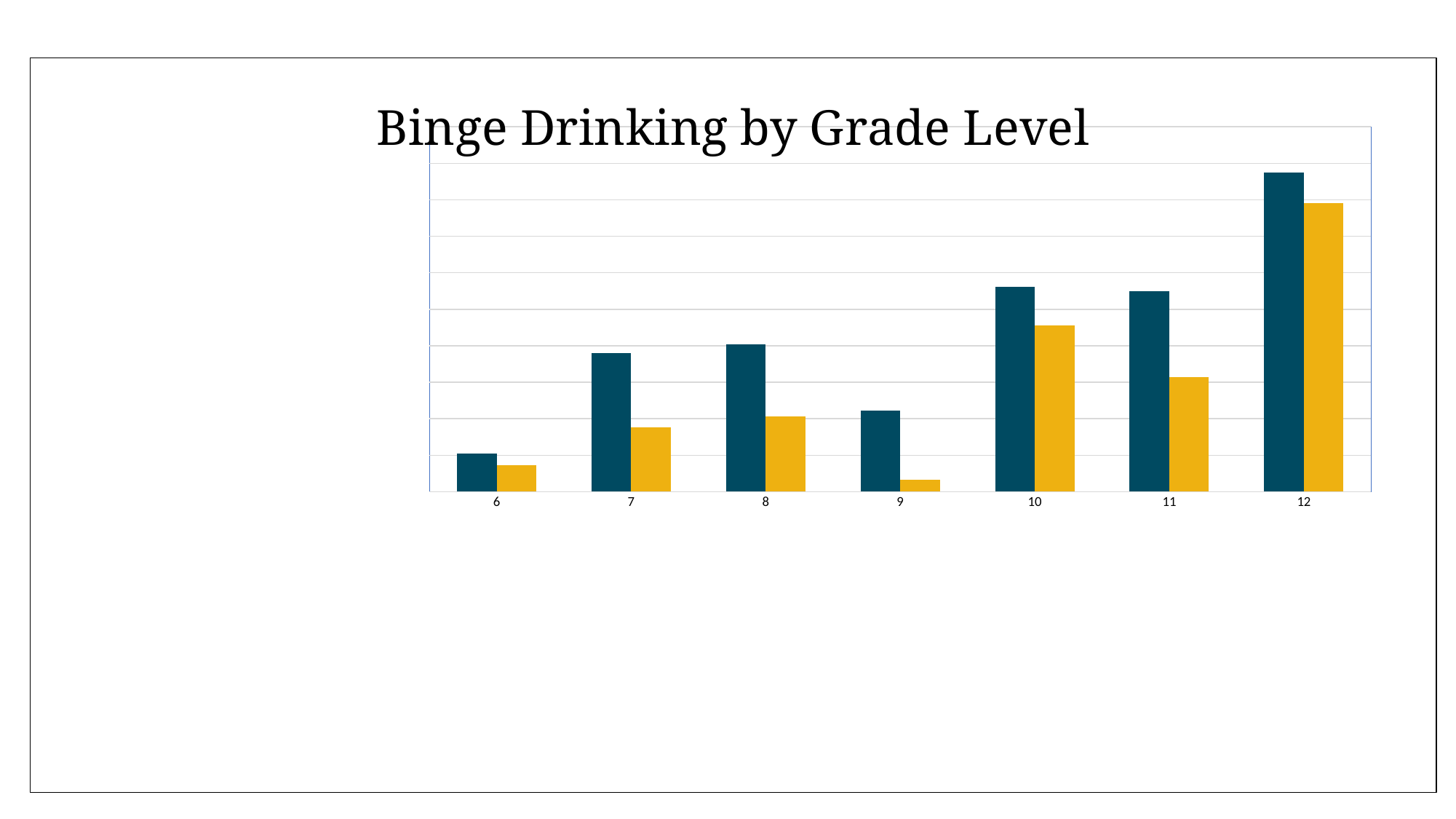
From grade 9 to grade 12, do the dark blue bars rise or fall? rise How many grade levels are shown on the x axis of the chart? 7 Which grade level has the shortest dark blue bar? 6 What is the title of the chart? Binge Drinking by Grade Level Which grade level has the tallest dark blue bar? 12 At grade 9, which bar is taller, the dark blue bar or the yellow bar? dark blue What kind of chart is shown on the slide? bar chart How many bars are shown for each grade level in the chart? 2 Which grade level has the shortest yellow bar? 9 Is the dark blue bar taller at grade 7 or at grade 8? grade 8 Is the yellow bar taller at grade 10 or at grade 11? grade 10 Which grade level has the tallest yellow bar? 12